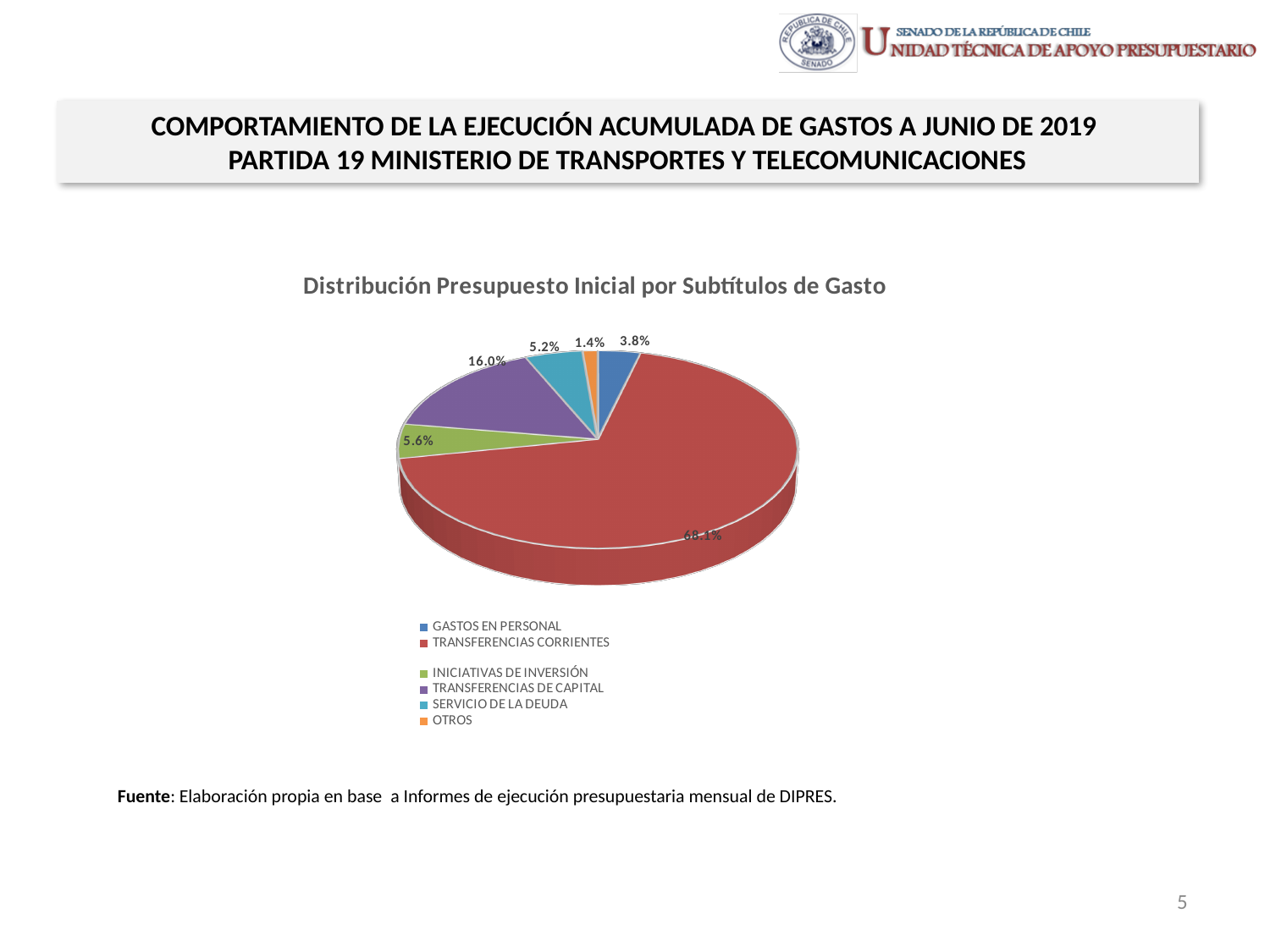
What share of the pie is TRANSFERENCIAS CORRIENTES? 68.1% What share of the pie is TRANSFERENCIAS DE CAPITAL? 16.0% What share of the pie is GASTOS EN PERSONAL? 3.8% What is the difference between the shares of TRANSFERENCIAS DE CAPITAL and INICIATIVAS DE INVERSIÓN? 10.4% What is the title of the chart? Distribución Presupuesto Inicial por Subtítulos de Gasto How many categories does the legend list? 6 Which category has the largest share of the pie? TRANSFERENCIAS CORRIENTES Which category has the smallest share of the pie? OTROS Which is larger, the share for INICIATIVAS DE INVERSIÓN or the share for GASTOS EN PERSONAL? INICIATIVAS DE INVERSIÓN What kind of chart is shown on the slide? pie chart